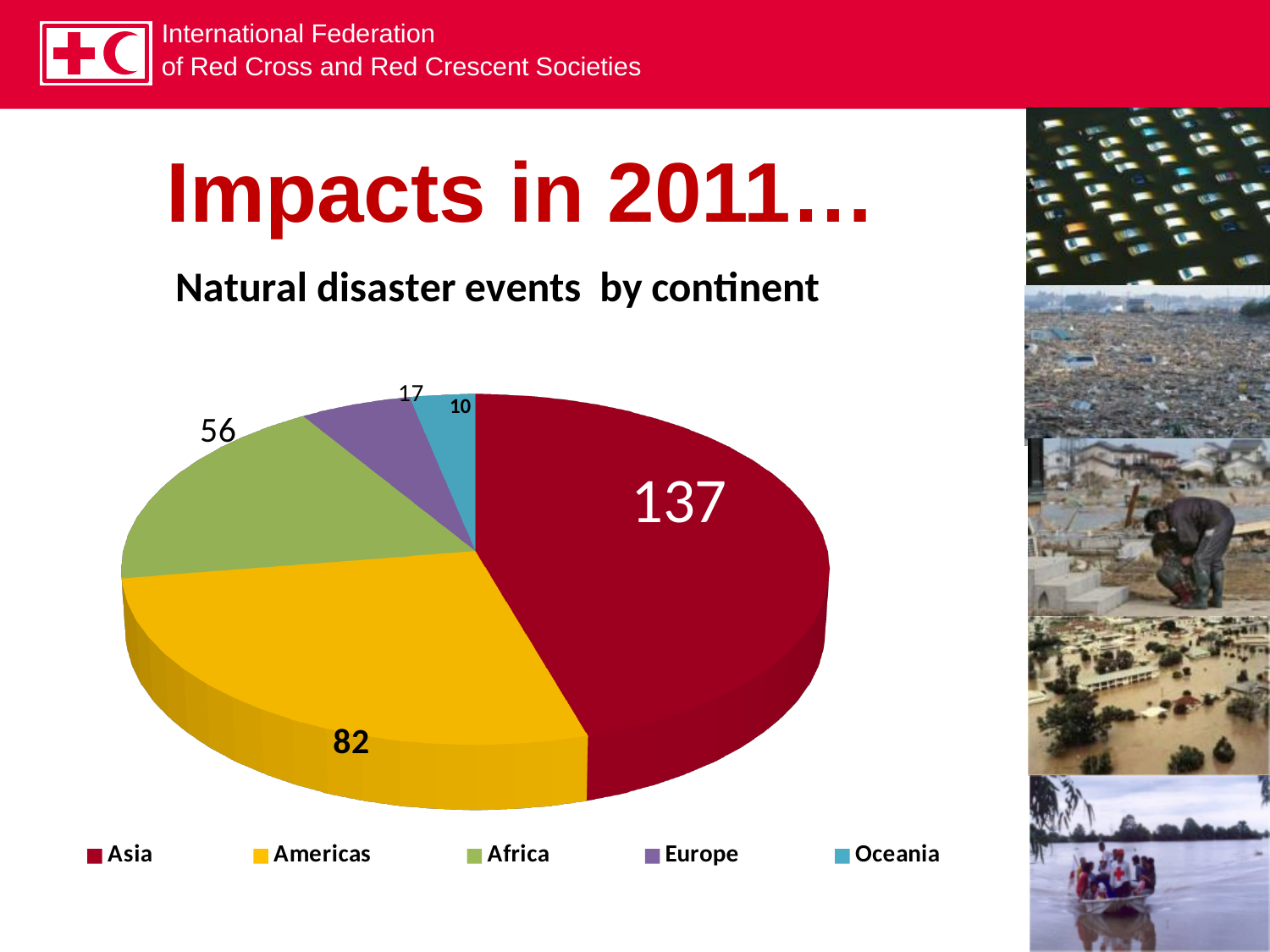
Which has more natural disaster events, Africa or Europe? Africa What is the difference between the number of events in Asia and the Americas? 55 How many natural disaster events are shown for Africa? 56 Which continent has the highest number of natural disaster events? Asia Which continent has the lowest number of natural disaster events? Oceania What kind of chart is shown on the slide? pie chart How many natural disaster events are shown for Europe? 17 How many continents are shown in the pie chart? 5 What is the title of the chart? Natural disaster events by continent How many natural disaster events are shown for Oceania? 10 How many natural disaster events are shown for Asia? 137 How many natural disaster events are shown for the Americas? 82